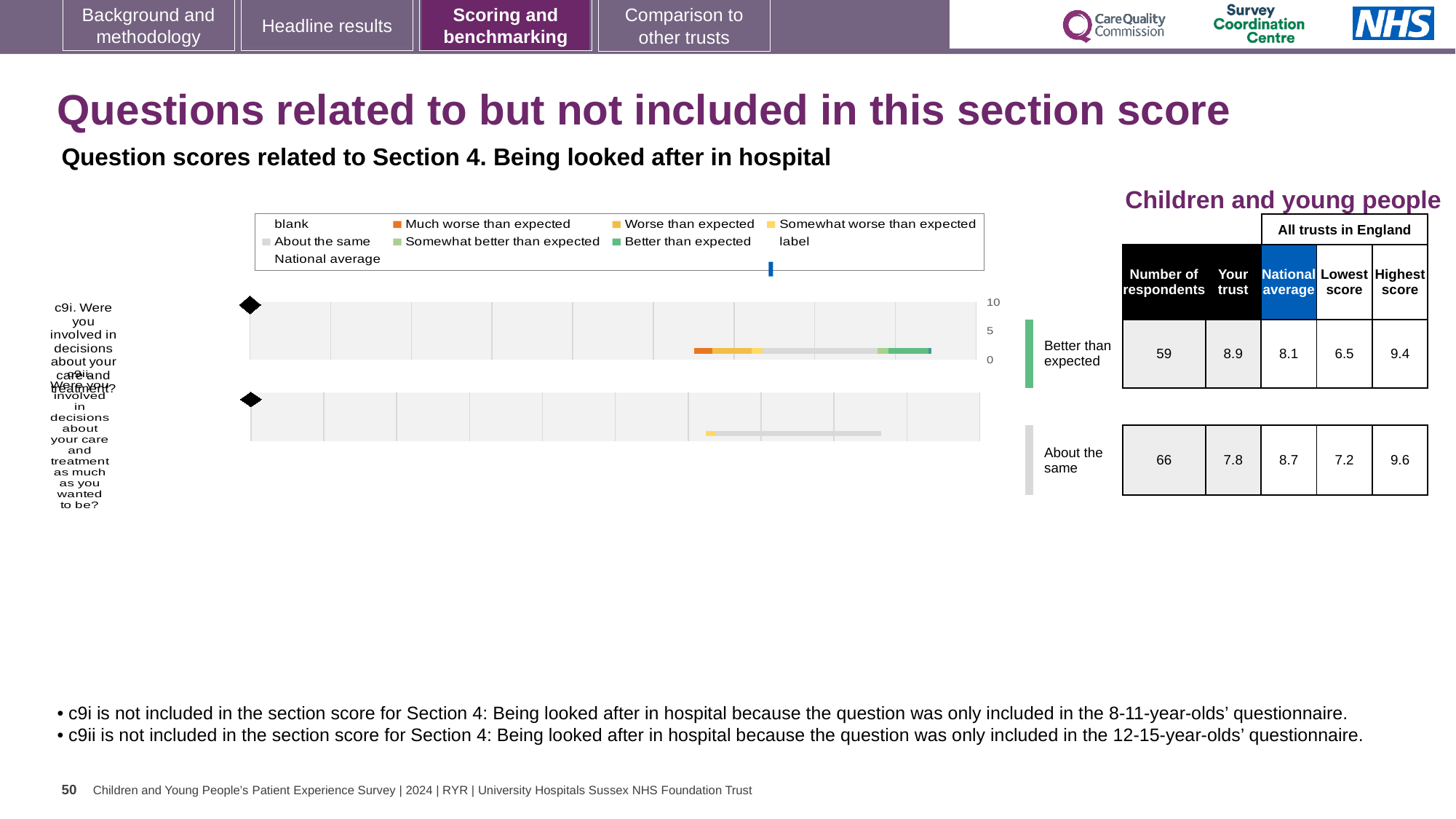
What is the 'Your trust' score for question c9i? 8.9 What is the difference between the 'Your trust' score and the national average for question c9i? 0.8 What benchmark category is question c9i rated as? Better than expected Which is larger for question c9ii: the 'Your trust' score or the national average? National average What benchmark category is question c9ii rated as? About the same What is the lowest score across all trusts in England for question c9i? 6.5 How many questions (categories) are plotted in the chart? 2 What kind of chart is shown on the slide? bar chart What is the highest score across all trusts in England for question c9ii? 9.6 How many respondents answered question c9i? 59 What is the national average score for question c9ii? 8.7 What is the highest value shown on the chart's score axis? 10